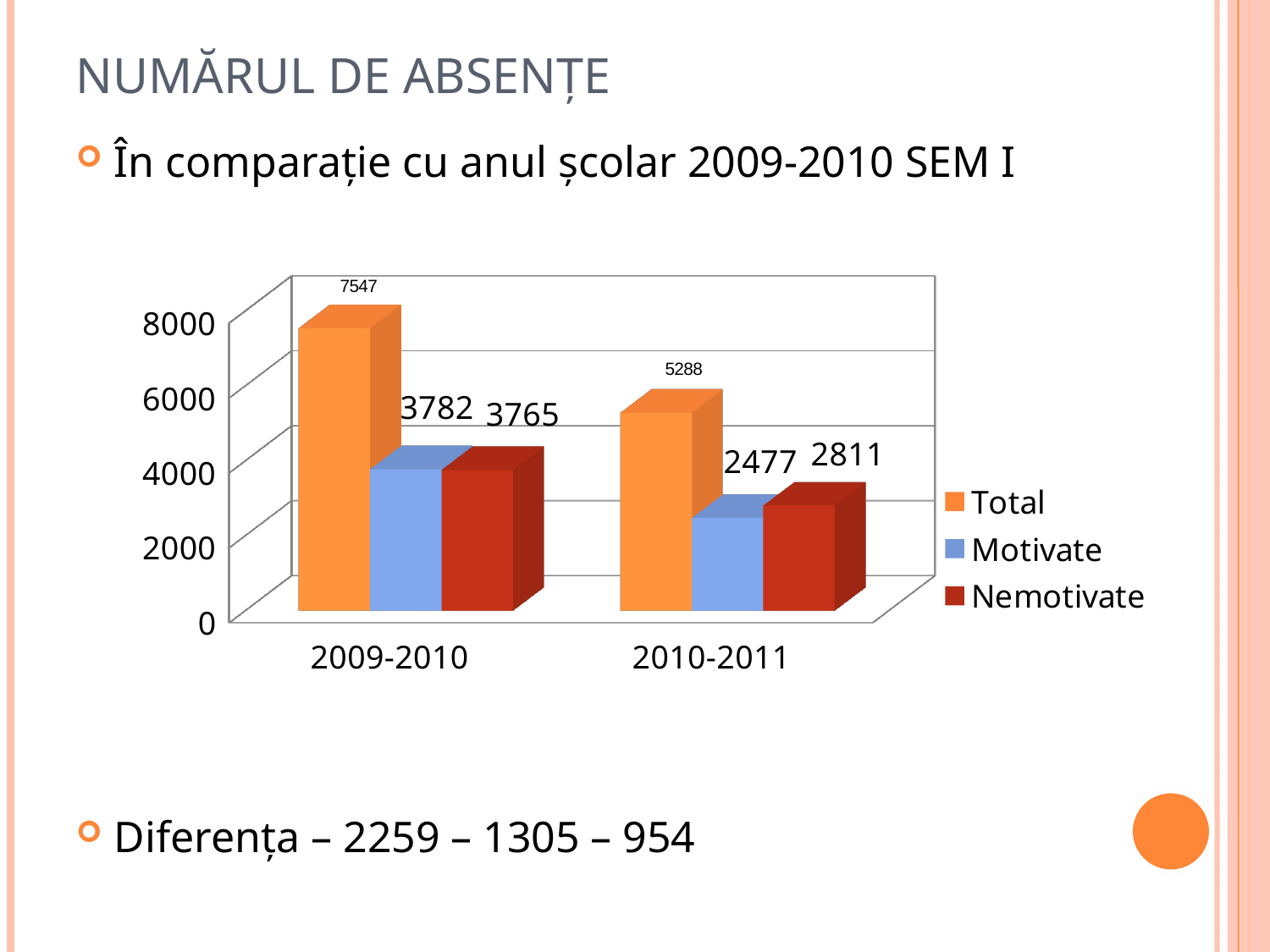
What is the Motivate value for 2010-2011? 2477 What is the Total value for 2009-2010? 7547 What is the difference between the Total values for 2009-2010 and 2010-2011? 2259 How many series does the legend list? 3 What is the Total value for 2010-2011? 5288 How many categories are shown on the x axis? 2 What kind of chart is shown on the slide? bar chart Which category has the higher Total value? 2009-2010 Which series is shown in orange in the legend? Total What is the difference between the Motivate values for 2009-2010 and 2010-2011? 1305 What is the Nemotivate value for 2009-2010? 3765 Is the Nemotivate value for 2010-2011 larger or smaller than the Motivate value for 2010-2011? larger